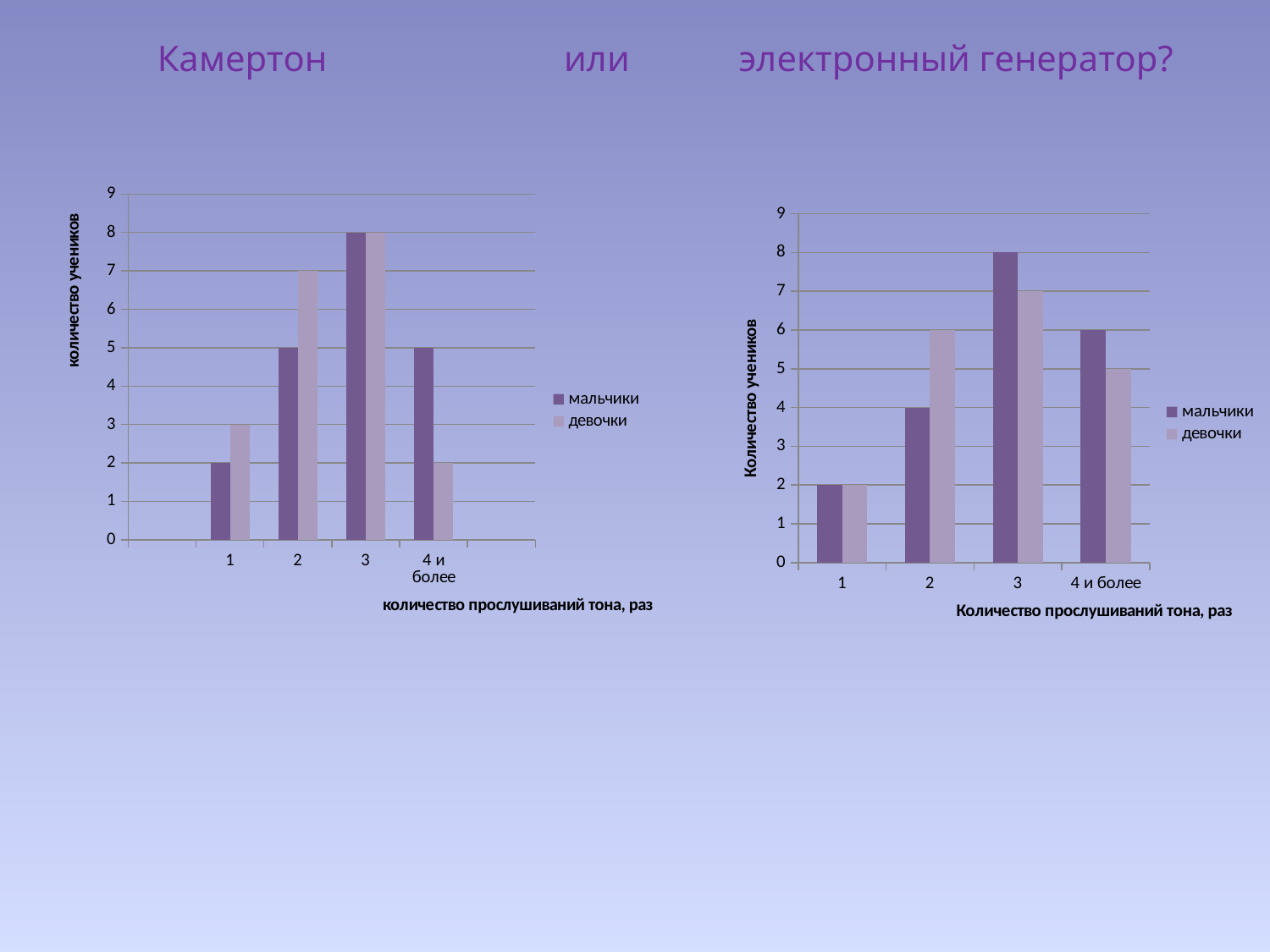
What is the x-axis title of the right chart? Количество прослушиваний тона, раз What type of chart is the left chart? bar chart On the left chart, what is the value for мальчики at category 3? 8 On the left chart, what is the difference between девочки and мальчики at category 1? 1 How many series does the legend of the left chart list? 2 On the right chart, which category has the highest value for мальчики? 3 On the right chart, which is larger at category 2: мальчики or девочки? девочки On the left chart, what is the value for девочки at category 2? 7 How many categories are shown on the x axis of the right chart? 4 On the right chart, what is the value for мальчики at category '4 и более'? 6 On the left chart, which category has the lowest value for девочки? 4 и более On the right chart, what is the value for девочки at category 3? 7